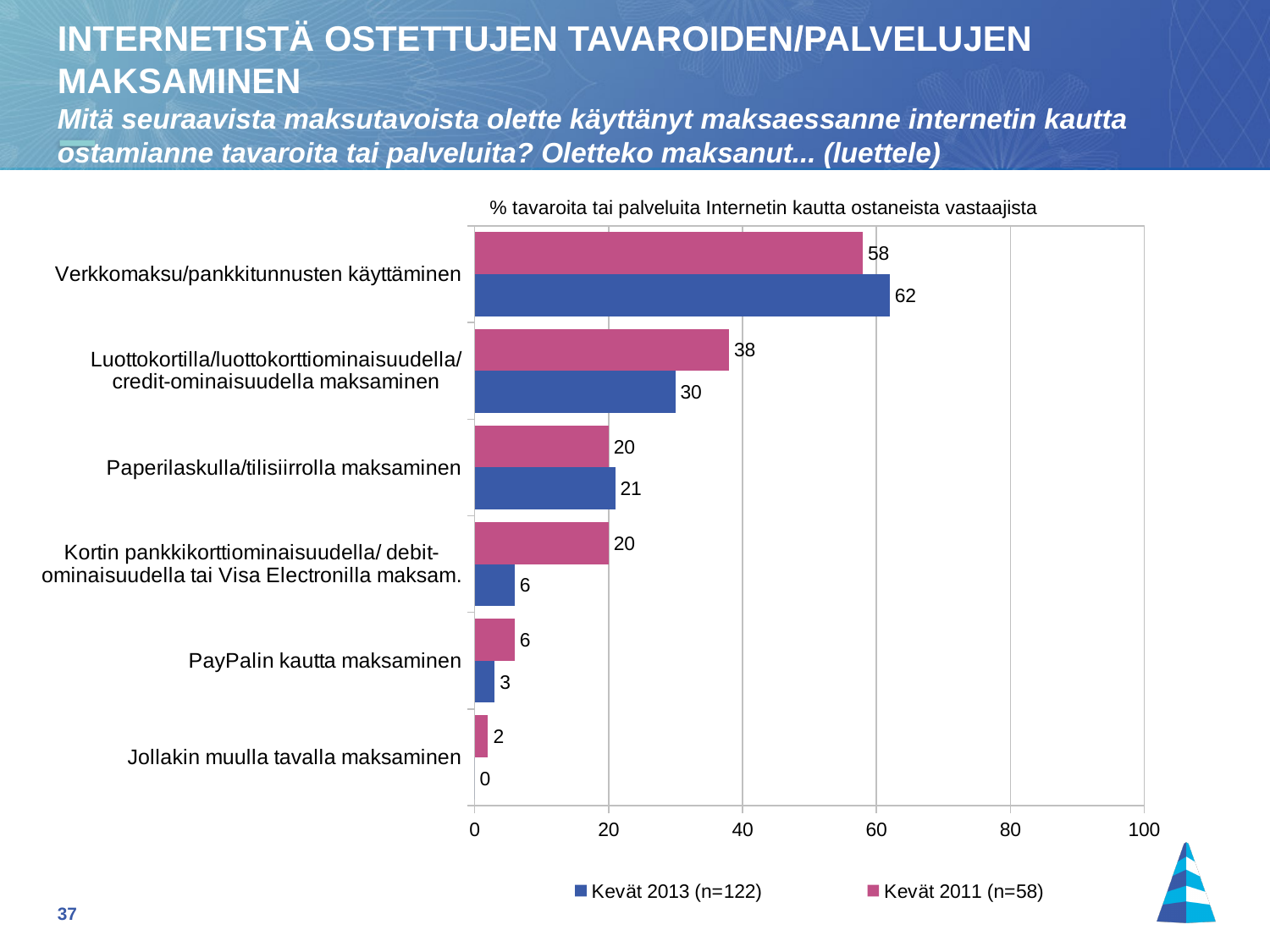
What is the value for Luottokortilla/luottokorttiominaisuudella/credit-ominaisuudella maksaminen in the Kevät 2011 (n=58) series? 38 Which category has the lowest value in the Kevät 2011 (n=58) series? Jollakin muulla tavalla maksaminen What is the value for Verkkomaksu/pankkitunnusten käyttäminen in the Kevät 2013 (n=122) series? 62 Which category has the highest value in the Kevät 2013 (n=122) series? Verkkomaksu/pankkitunnusten käyttäminen For Luottokortilla/luottokorttiominaisuudella/credit-ominaisuudella maksaminen, which series has the larger value, Kevät 2013 (n=122) or Kevät 2011 (n=58)? Kevät 2011 (n=58) Is the Kevät 2013 (n=122) value for Verkkomaksu/pankkitunnusten käyttäminen greater or less than 60? greater How many categories are shown on the chart? 6 What is the value for PayPalin kautta maksaminen in the Kevät 2013 (n=122) series? 3 What is the value for Jollakin muulla tavalla maksaminen in the Kevät 2013 (n=122) series? 0 What kind of chart is shown on the slide? Bar chart How many series does the legend list? 2 What is the difference between the Kevät 2011 (n=58) and Kevät 2013 (n=122) values for Kortin pankkikorttiominaisuudella/ debit-ominaisuudella tai Visa Electronilla maksam.? 14